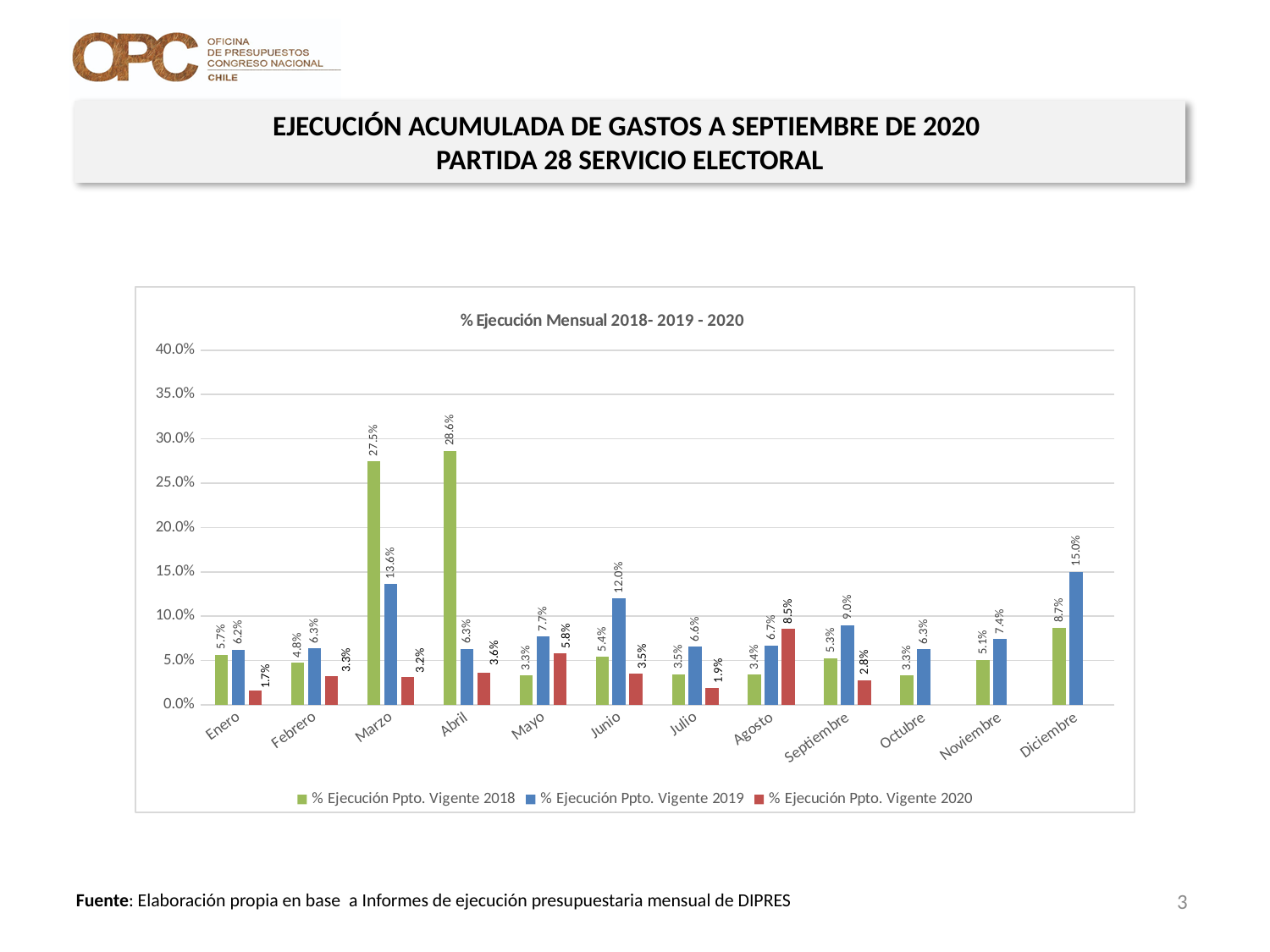
What kind of chart is shown on the slide? Bar chart How many months are shown on the x axis? 12 What is the value for % Ejecución Ppto. Vigente 2018 in Abril? 28.6% How many series does the legend list? 3 What is the difference between the 2018 and 2019 values in Marzo? 13.9% What is the title of the chart? % Ejecución Mensual 2018- 2019 - 2020 Which is larger in Mayo: the 2019 value or the 2020 value? 2019 value What is the value for % Ejecución Ppto. Vigente 2020 in Agosto? 8.5% Which month has the lowest value for % Ejecución Ppto. Vigente 2020? Enero Which month has the highest value for % Ejecución Ppto. Vigente 2019? Diciembre Is the value for % Ejecución Ppto. Vigente 2018 in Marzo greater or less than 25.0%? greater What is the value for % Ejecución Ppto. Vigente 2019 in Junio? 12.0%